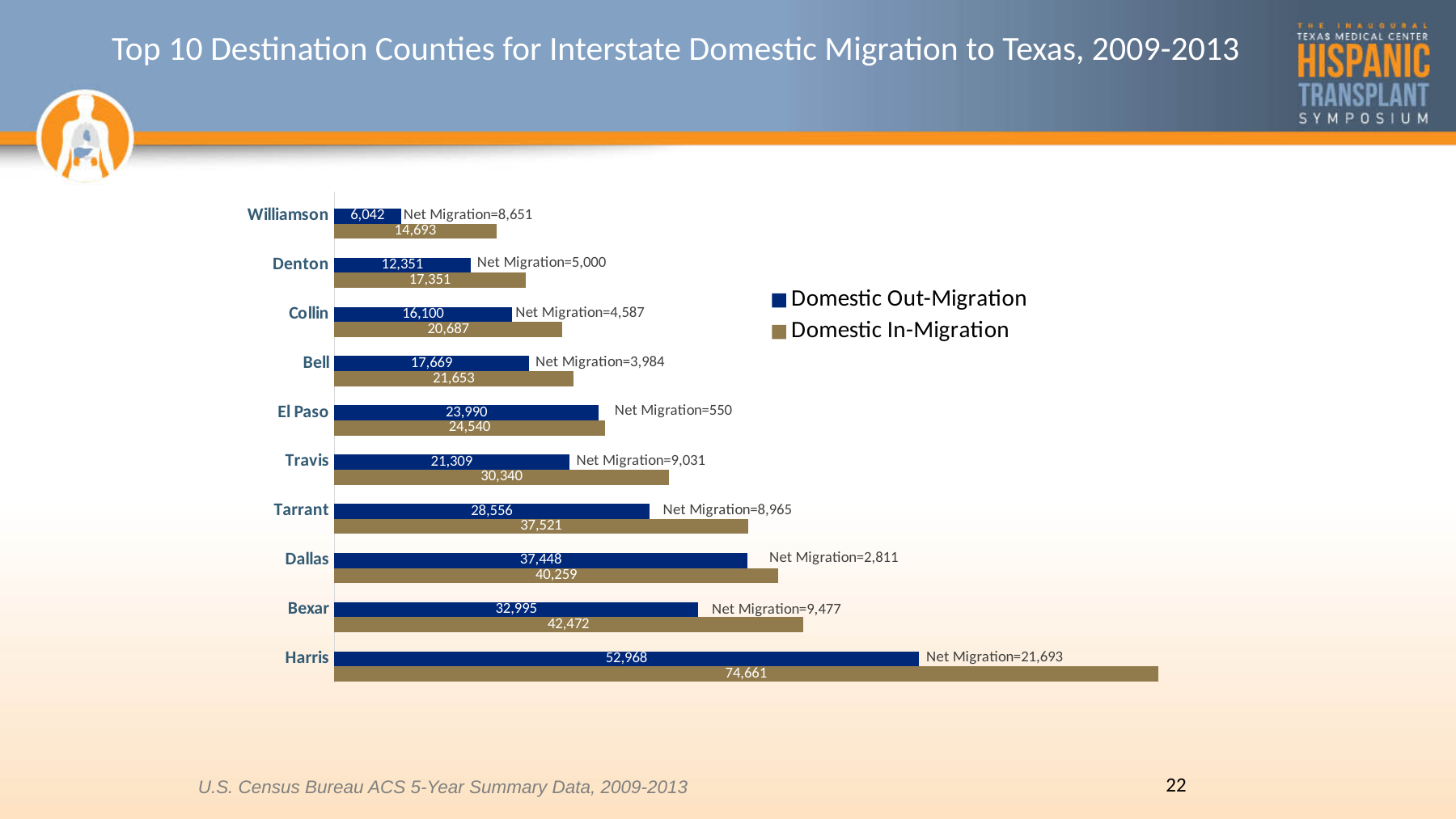
What kind of chart is shown on the slide? Bar chart What is the net migration value shown for El Paso? 550 How many series does the legend list? 2 How many counties are shown in the chart? 10 What is the Domestic Out-Migration value for Dallas? 37,448 Which county has the highest Domestic In-Migration? Harris Which county has the lowest Domestic Out-Migration? Williamson Which is larger for Tarrant: Domestic In-Migration or Domestic Out-Migration? Domestic In-Migration What is the title of the chart? Top 10 Destination Counties for Interstate Domestic Migration to Texas, 2009-2013 What is the difference between Domestic In-Migration and Domestic Out-Migration for Bexar? 9,477 What is the Domestic In-Migration value for Harris? 74,661 What is the Domestic In-Migration value for Travis? 30,340